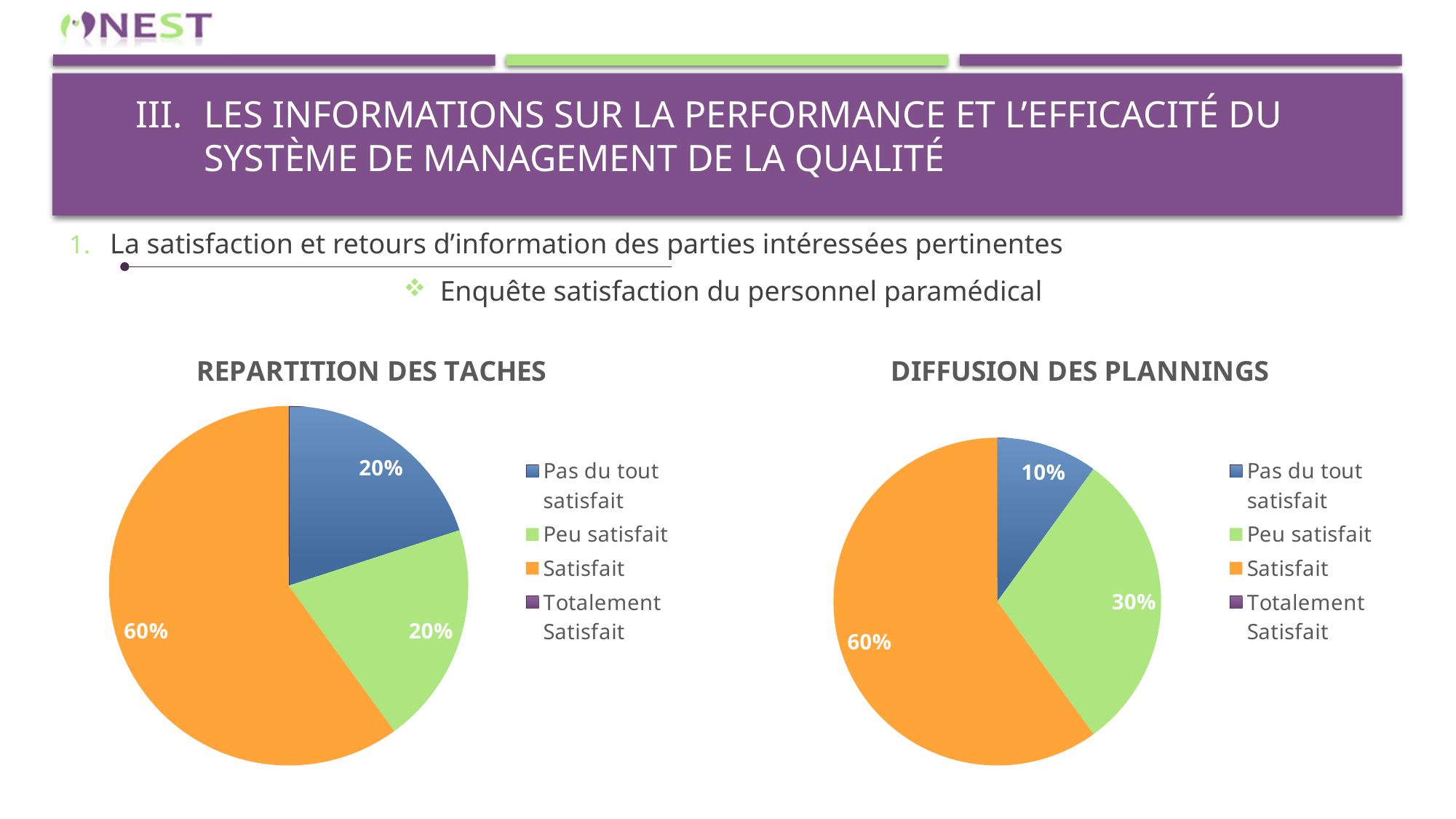
In the 'REPARTITION DES TACHES' chart, what colour is the 'Satisfait' slice? Orange What type of chart is 'REPARTITION DES TACHES'? Pie chart In the 'DIFFUSION DES PLANNINGS' chart, which labelled category has the smallest slice? Pas du tout satisfait In the 'DIFFUSION DES PLANNINGS' chart, which category has the largest slice? Satisfait In the 'REPARTITION DES TACHES' chart, what is the difference between the 'Satisfait' share and the 'Peu satisfait' share? 40% In the 'DIFFUSION DES PLANNINGS' chart, what is the difference between the 'Peu satisfait' share and the 'Pas du tout satisfait' share? 20% In the 'REPARTITION DES TACHES' chart, what share is labelled for 'Pas du tout satisfait'? 20% In the 'DIFFUSION DES PLANNINGS' chart, which is larger: 'Peu satisfait' or 'Pas du tout satisfait'? Peu satisfait In the 'DIFFUSION DES PLANNINGS' chart, what share is labelled for 'Peu satisfait'? 30% In the 'DIFFUSION DES PLANNINGS' chart, what share is labelled for 'Pas du tout satisfait'? 10% How many entries does the legend of the 'DIFFUSION DES PLANNINGS' chart list? 4 In the 'REPARTITION DES TACHES' chart, what share is labelled for 'Satisfait'? 60%